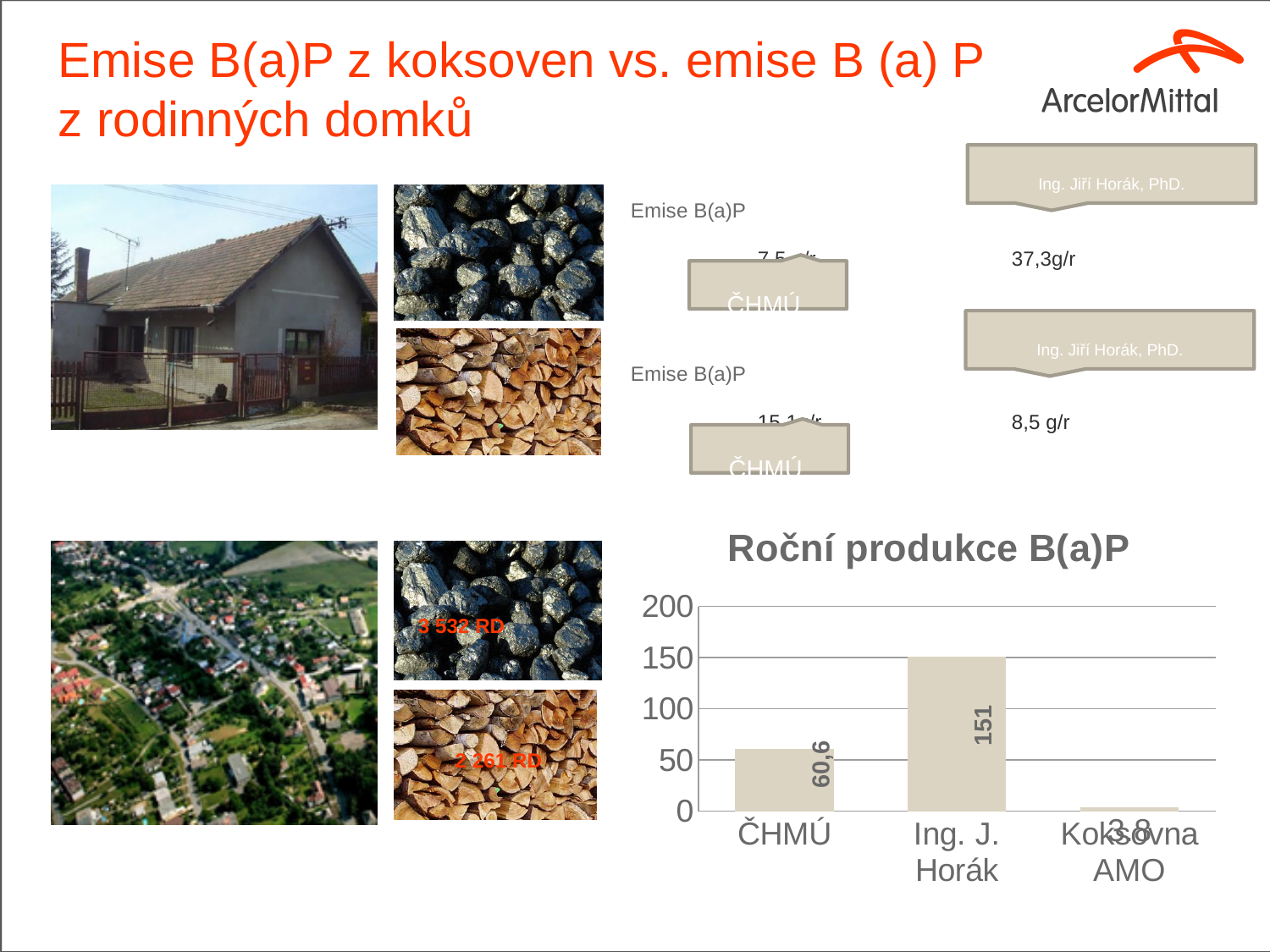
In the "Roční produkce B(a)P" chart, what is the value for ČHMÚ? 60,6 Which category has the highest value in the "Roční produkce B(a)P" chart? Ing. J. Horák In the "Roční produkce B(a)P" chart, what is the difference between the values for Ing. J. Horák and ČHMÚ? 90,4 Which category has the lowest value in the "Roční produkce B(a)P" chart? Koksovna AMO In the "Roční produkce B(a)P" chart, which is larger: the value for ČHMÚ or the value for Koksovna AMO? ČHMÚ In the "Roční produkce B(a)P" chart, what is the value for Ing. J. Horák? 151 What is the title of the bar chart on the slide? Roční produkce B(a)P In the "Roční produkce B(a)P" chart, what is the value for Koksovna AMO? 3,8 What kind of chart is shown under the title "Roční produkce B(a)P"? bar chart In the "Roční produkce B(a)P" chart, is the value for Ing. J. Horák greater or less than 100? greater In the "Roční produkce B(a)P" chart, is the value for ČHMÚ greater or less than 100? less How many categories are shown on the x axis of the "Roční produkce B(a)P" chart? 3